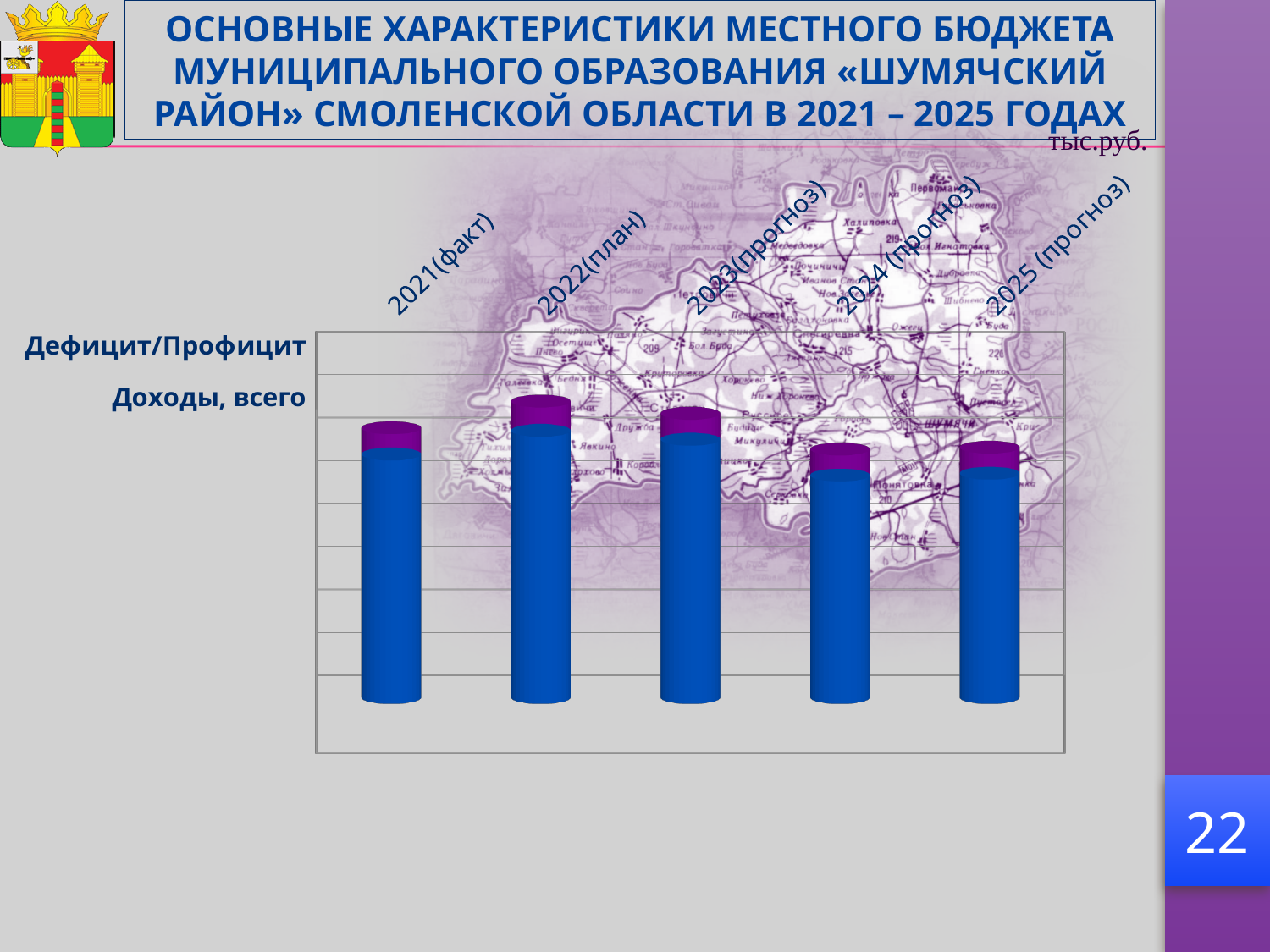
What unit is indicated for the chart's values? тыс.руб. Do the bars rise or fall from 2021(факт) to 2022(план)? rise Which bar is taller, 2021(факт) or 2023(прогноз)? 2023(прогноз) Do the bars rise or fall from 2022(план) to 2024 (прогноз)? fall Which year has the tallest bar in the chart? 2022(план) Which bar is taller, 2023(прогноз) or 2025 (прогноз)? 2023(прогноз) Which bar is taller, 2022(план) or 2024 (прогноз)? 2022(план) How many categories (years) are shown along the x axis of the chart? 5 What kind of chart is shown on the slide? bar chart